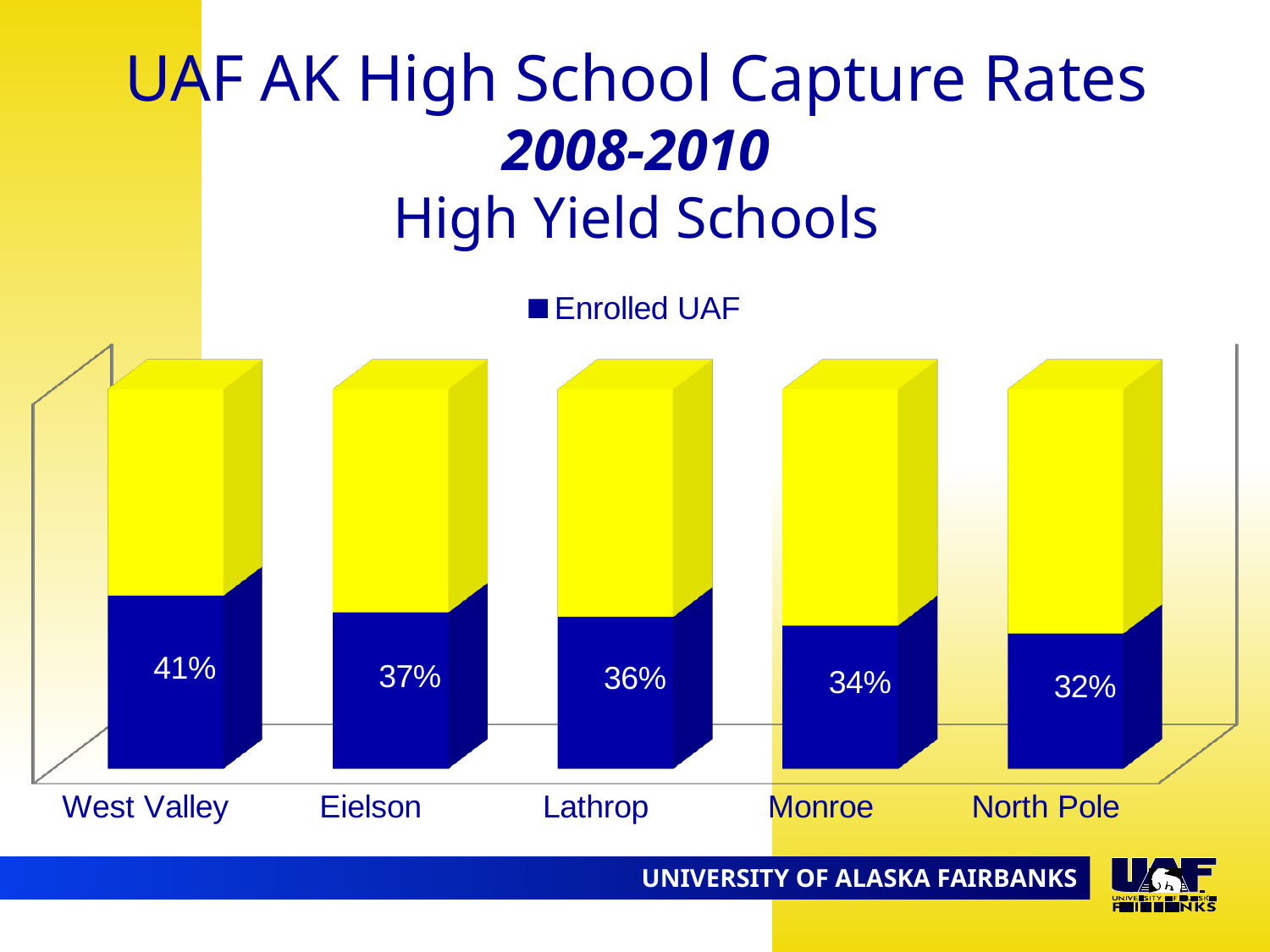
Which school has the lowest Enrolled UAF capture rate? North Pole What is the Enrolled UAF value for Lathrop? 36% Do the Enrolled UAF values rise or fall from West Valley to North Pole along the x axis? fall Which has a higher Enrolled UAF value, Eielson or Monroe? Eielson What is the Enrolled UAF value for Monroe? 34% Which school has the highest Enrolled UAF capture rate? West Valley How many series does the legend list? 1 What is the Enrolled UAF value for West Valley? 41% What is the difference between the Enrolled UAF values for West Valley and North Pole? 9% How many schools are shown on the chart? 5 What is the Enrolled UAF value for Eielson? 37% What is the Enrolled UAF value for North Pole? 32%